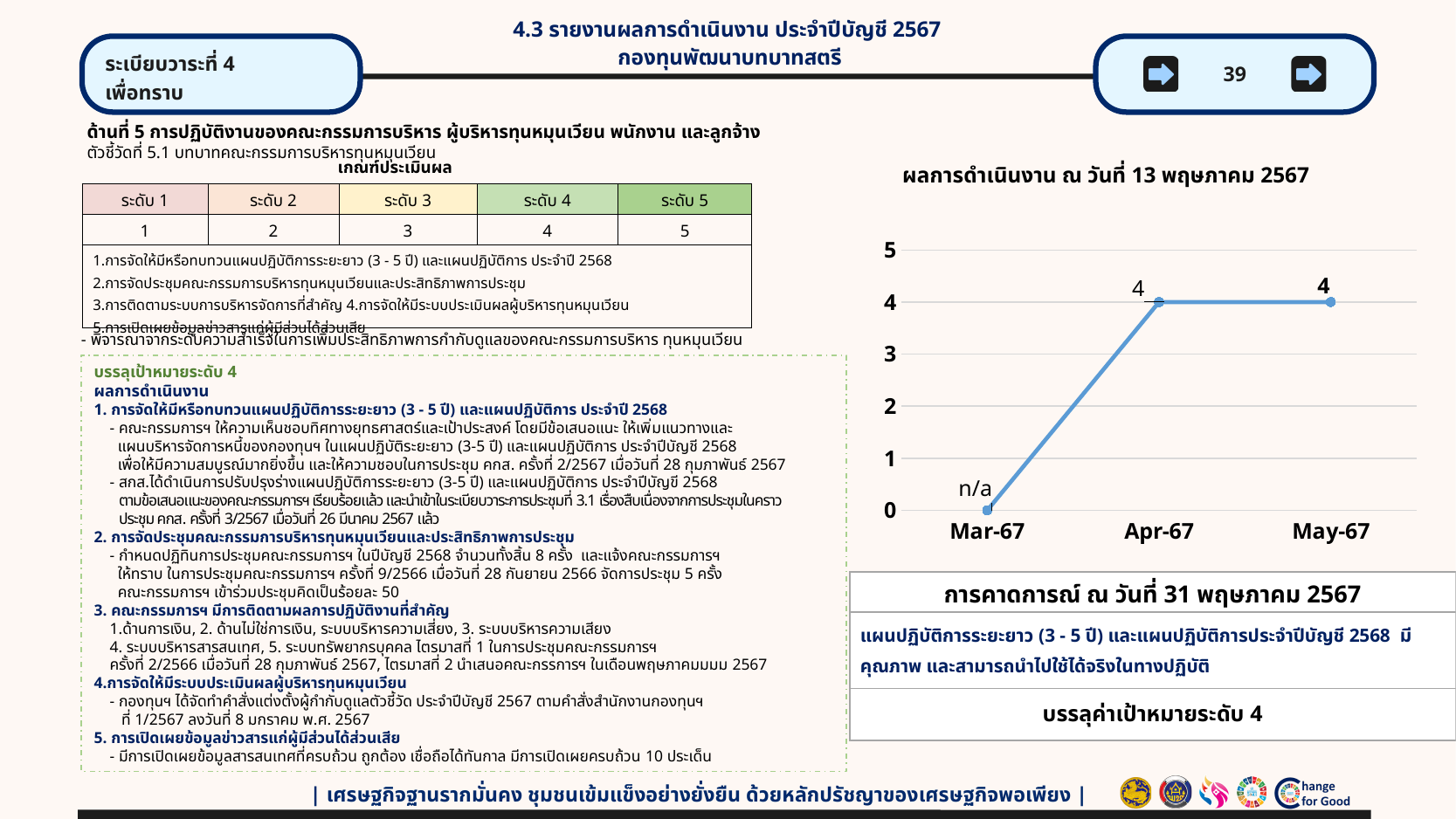
What is the title of the chart on the slide? ผลการดำเนินงาน ณ วันที่ 13 พฤษภาคม 2567 What is the value plotted for May-67? 4 What data label is shown for Mar-67? n/a What is the value plotted for Apr-67? 4 What is the difference between the values for Apr-67 and May-67? 0 Is the value for Mar-67 greater or less than 1? less Which month has the lowest plotted value on the chart? Mar-67 How many points are plotted along the x axis of the chart? 3 Does the line rise, fall, or stay flat between Apr-67 and May-67? stays flat What type of chart is shown on the slide? line chart Is the value for Apr-67 greater or less than 3? greater What is the highest tick value shown on the y axis of the chart? 5